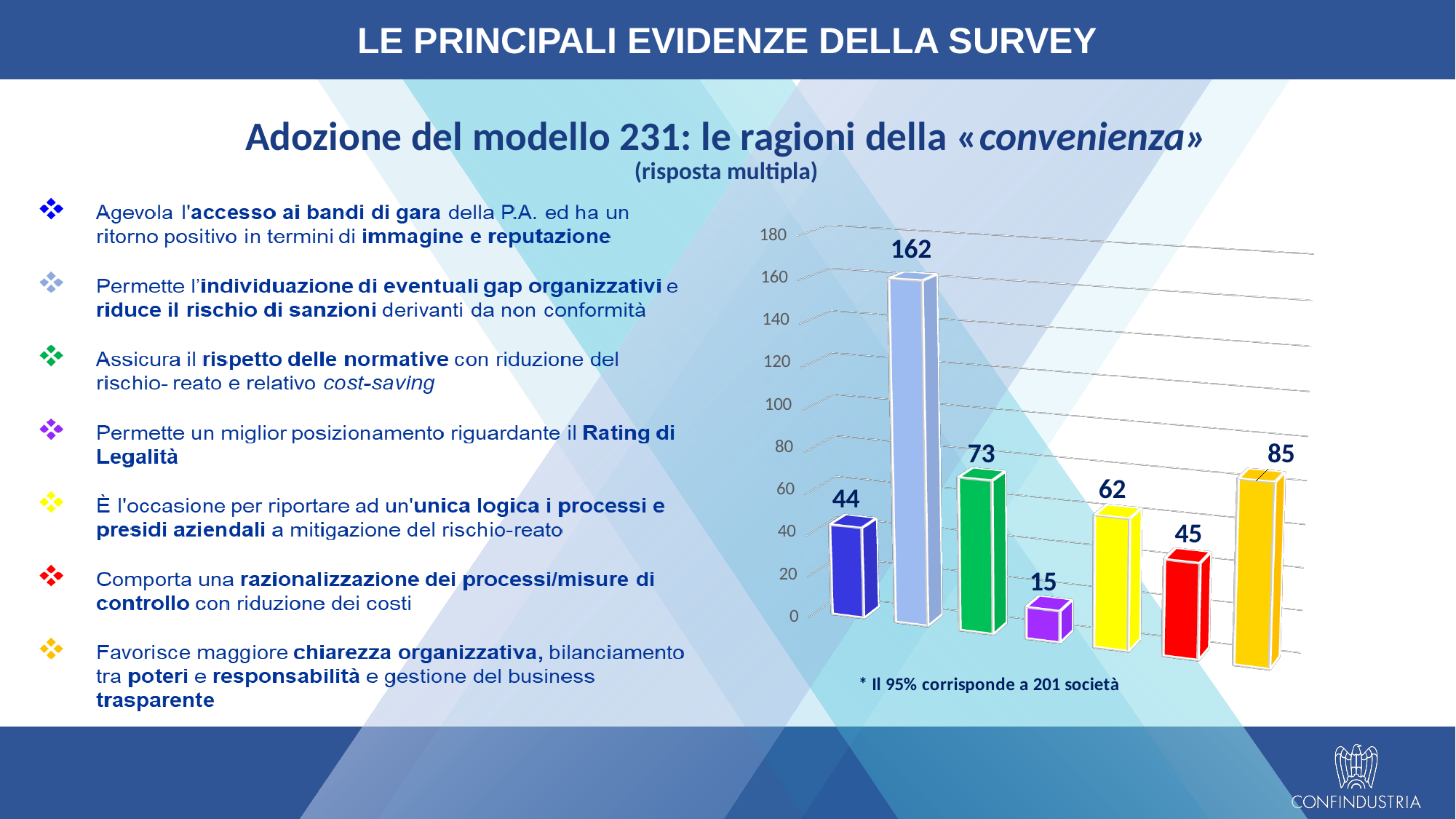
What value is shown on the first bar from the left (dark blue)? 44 What value is shown on the rightmost (gold) bar? 85 What value is shown on the red bar? 45 What type of chart is shown on the slide? bar chart How many bars are plotted in the chart? 7 What value is shown on the green bar? 73 What is the difference between the light blue bar (162) and the green bar (73)? 89 What is the value of the tallest bar in the chart? 162 Which is larger, the yellow bar or the red bar? the yellow bar (62) What is the difference between the gold bar (85) and the purple bar (15)? 70 What is the value of the shortest bar in the chart? 15 What is the highest value shown on the vertical axis of the chart? 180